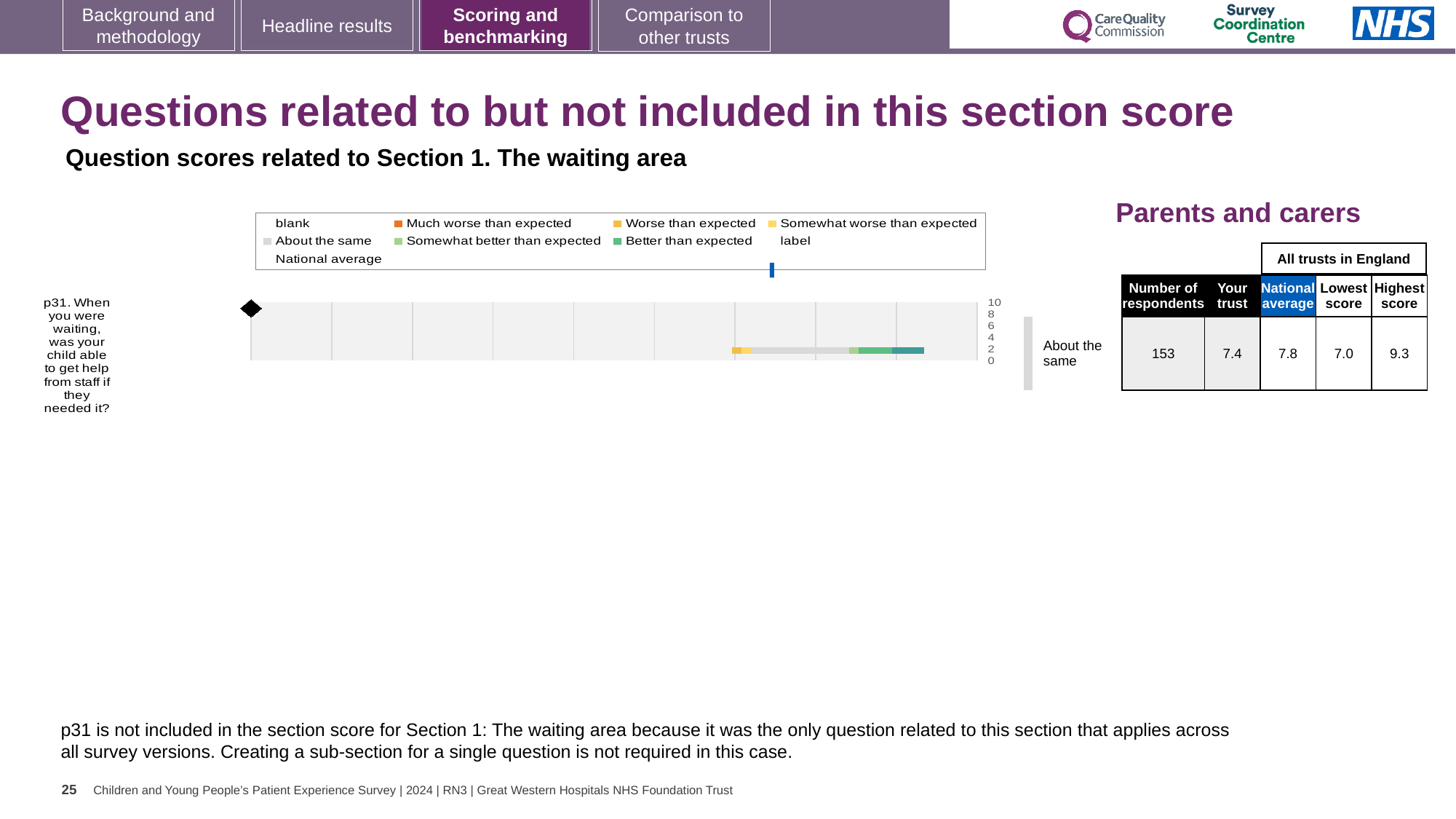
In the Parents and carers table, how many respondents answered p31? 153 In the Parents and carers table, what is the National average score for p31? 7.8 In the Parents and carers table, what is the 'Your trust' score for p31? 7.4 For p31, which is larger: the 'Your trust' score or the National average? National average Which question number is plotted in the chart? p31 What benchmark label is shown to the right of the p31 bar? About the same In the Parents and carers table, what is the Highest score for p31 across all trusts in England? 9.3 In the Parents and carers table, what is the Lowest score for p31 across all trusts in England? 7.0 For p31, what is the difference between the National average and the 'Your trust' score? 0.4 What kind of chart is used to show the p31 question score? bar chart For p31, what is the difference between the Highest score and the Lowest score across all trusts in England? 2.3 How many questions are plotted in the chart? 1